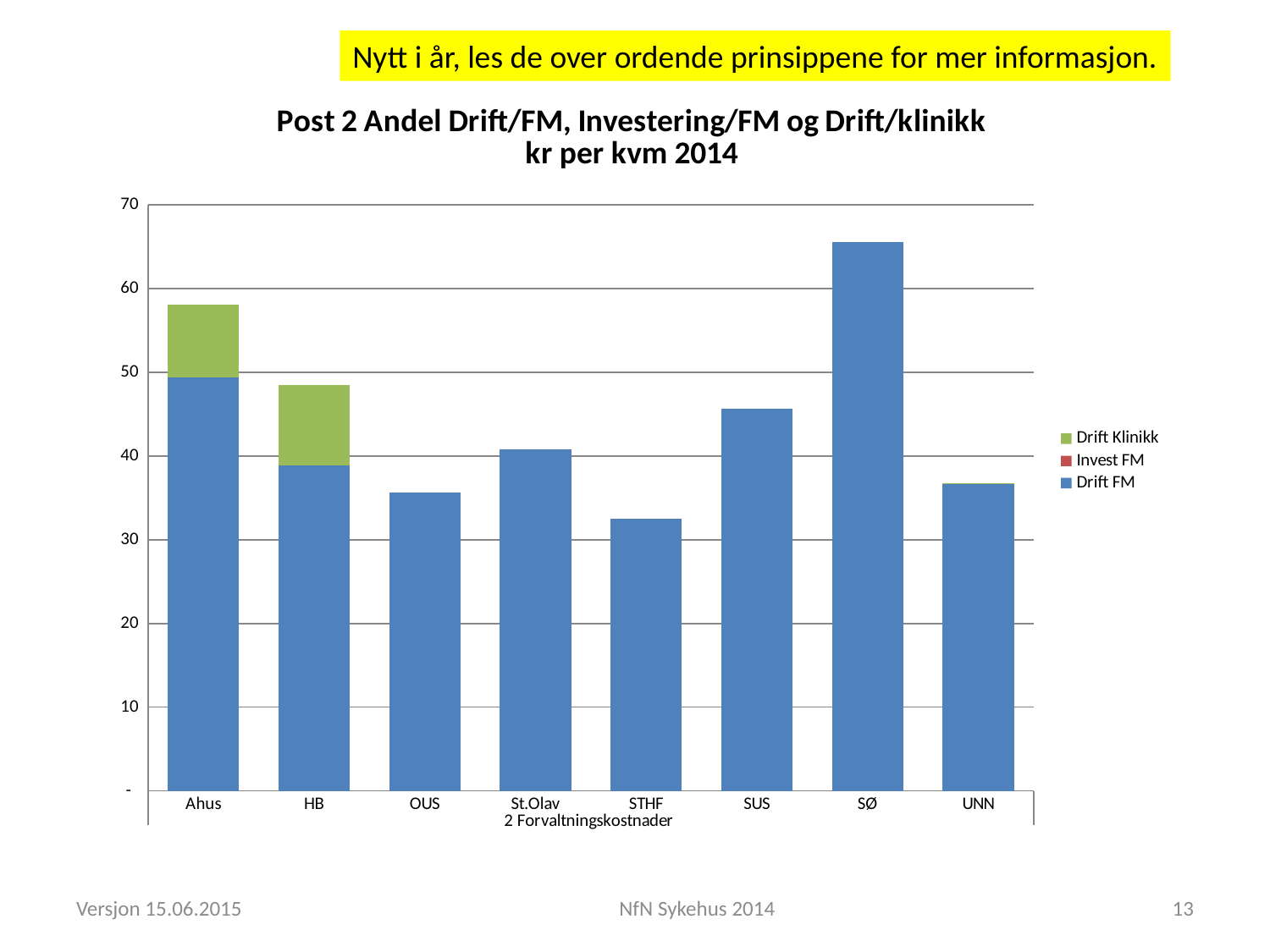
Which category has the lowest total bar in the chart? STHF Is the value for STHF greater or less than 40? less What is the title of the chart? Post 2 Andel Drift/FM, Investering/FM og Drift/klinikk kr per kvm 2014 Which category has the highest total bar in the chart? SØ How many categories are shown along the x axis of the chart? 8 What kind of chart is shown on the slide? bar chart Which series is shown in green in the chart's legend? Drift Klinikk Is the value for SØ greater or less than 60? greater Which is larger, the bar for SUS or the bar for OUS? SUS Is the value for UNN greater or less than 40? less How many series does the chart's legend list? 3